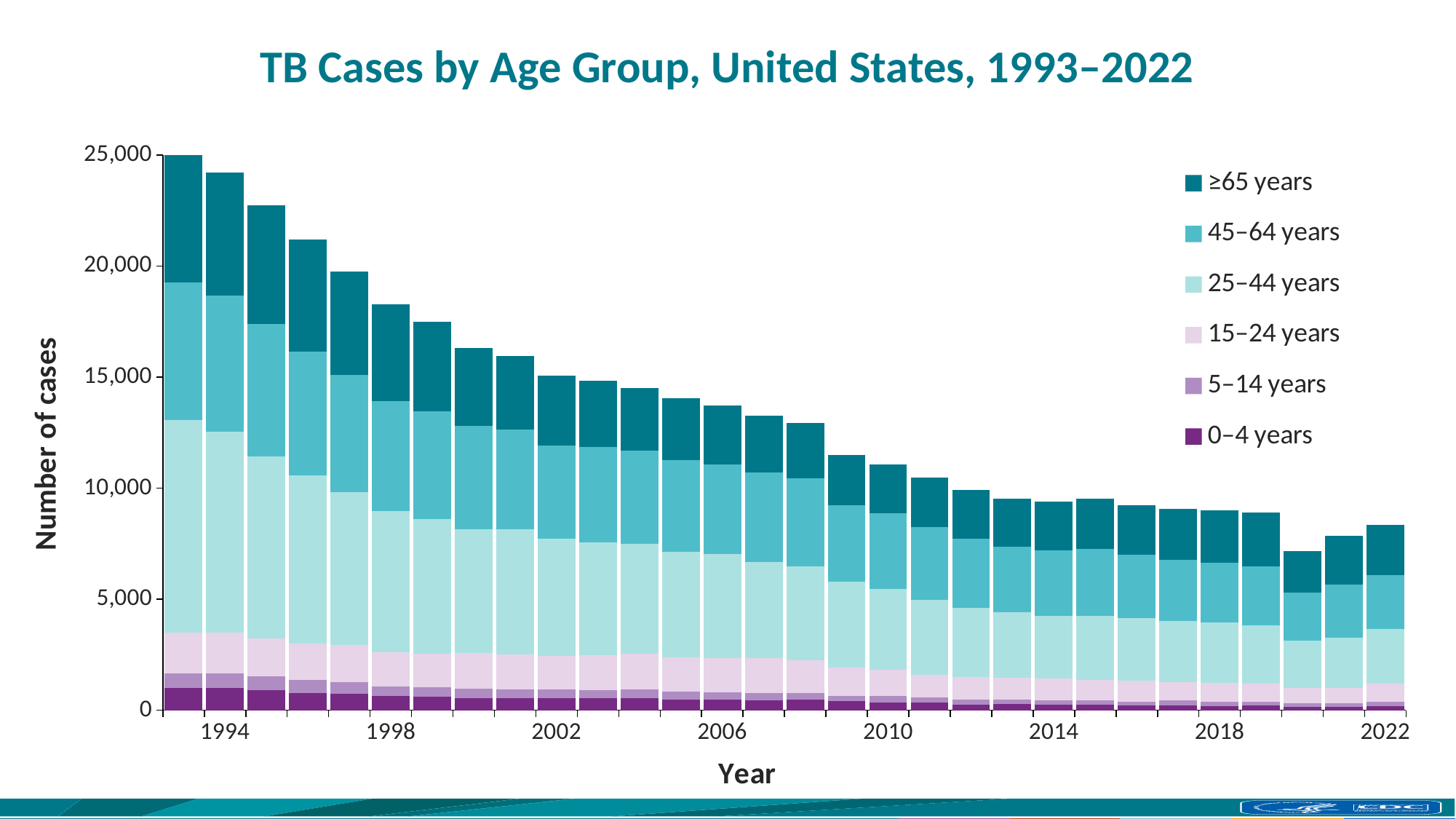
What is the title of the chart? TB Cases by Age Group, United States, 1993–2022 Which year has more total TB cases, 1994 or 2014? 1994 How many age-group series does the legend list? 6 What label is shown on the y axis? Number of cases Overall, do total TB cases rise or fall from 1993 to 2022? Fall Which year has the highest total number of TB cases? 1993 Is the total number of TB cases in 2006 greater or less than 15,000? less What kind of chart is shown on the slide? Stacked bar chart How many years (bars) are plotted on the chart? 30 Which year has the lowest total number of TB cases? 2020 Is the total number of TB cases in 2022 greater or less than 10,000? less Is the total number of TB cases in 1993 greater or less than 20,000? greater